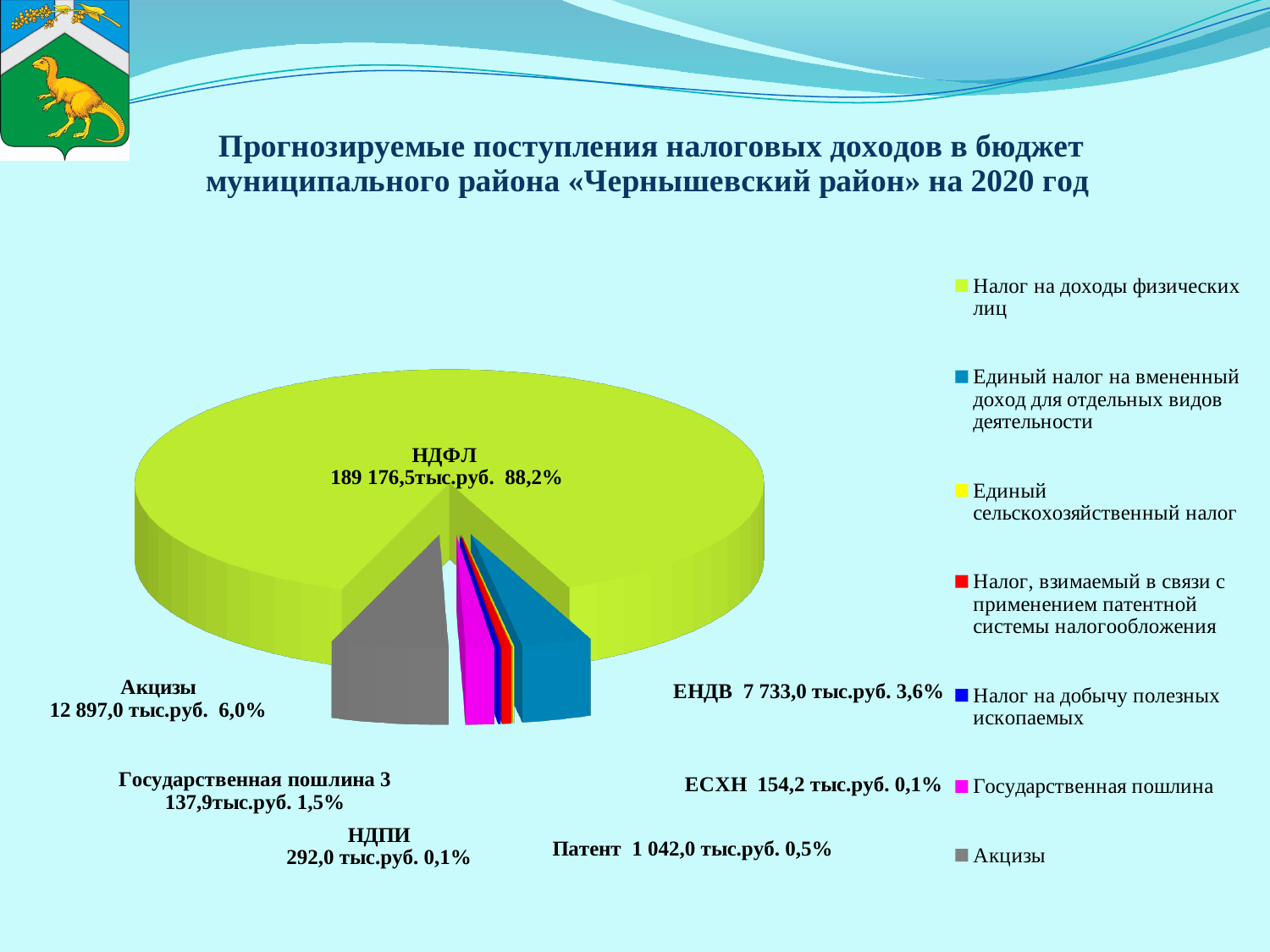
What is the difference between the values for Акцизы and ЕНДВ? 5 164,0 тыс.руб. What is the forecast value for Патент? 1 042,0 тыс.руб. Which category has the largest slice of the pie? НДФЛ Which category has the smallest forecast value in тыс.руб.? ЕСХН How many entries does the legend list? 7 What is the forecast value for ЕНДВ? 7 733,0 тыс.руб. Which is larger, the value for НДПИ or the value for ЕСХН? НДПИ What is the forecast value for НДФЛ? 189 176,5 тыс.руб. What share of the pie does НДФЛ account for? 88,2% What is the forecast value for Акцизы? 12 897,0 тыс.руб. What share of the pie does Государственная пошлина account for? 1,5% What kind of chart is shown on the slide? pie chart